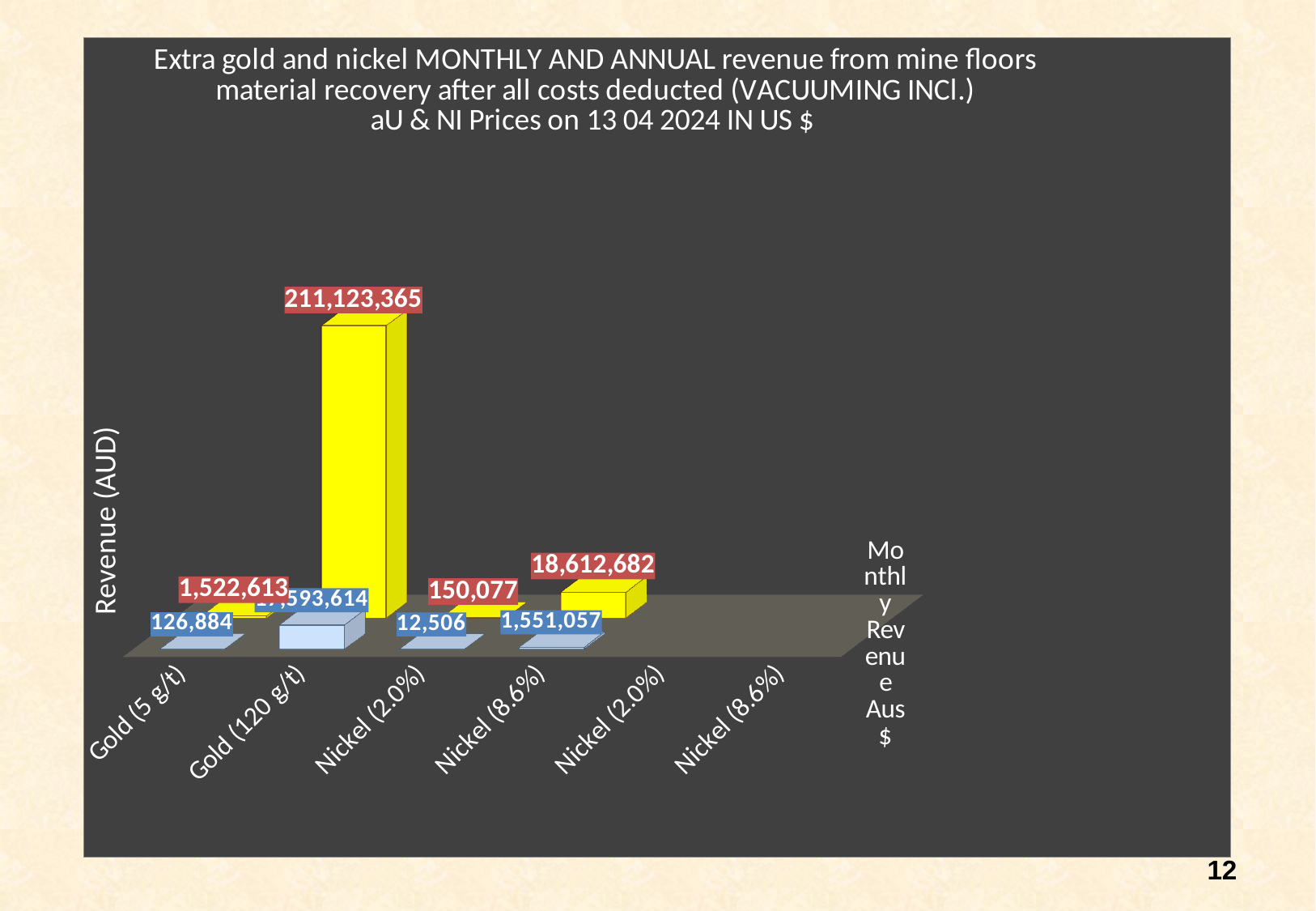
What is the title of the vertical axis? Revenue (AUD) What is the value of the red-labelled (annual) bar for Gold (120 g/t)? 211,123,365 What is the value of the blue-labelled (monthly) bar for Gold (5 g/t)? 126,884 What is the difference between the red-labelled (annual) value and the blue-labelled (monthly) value for Nickel (8.6%)? 17,061,625 What is the value of the blue-labelled (monthly) bar for Nickel (2.0%)? 12,506 What is the difference between the red-labelled (annual) value and the blue-labelled (monthly) value for Gold (5 g/t)? 1,395,729 Which category has the lowest labelled value on the chart? Nickel (2.0%) Which category has the highest labelled value on the chart? Gold (120 g/t) What is the value of the red-labelled (annual) bar for Nickel (2.0%)? 150,077 What kind of chart is shown on the slide? bar chart Which is larger: the red-labelled (annual) value for Nickel (8.6%) or the red-labelled (annual) value for Gold (5 g/t)? Nickel (8.6%) What is the value of the red-labelled (annual) bar for Nickel (8.6%)? 18,612,682